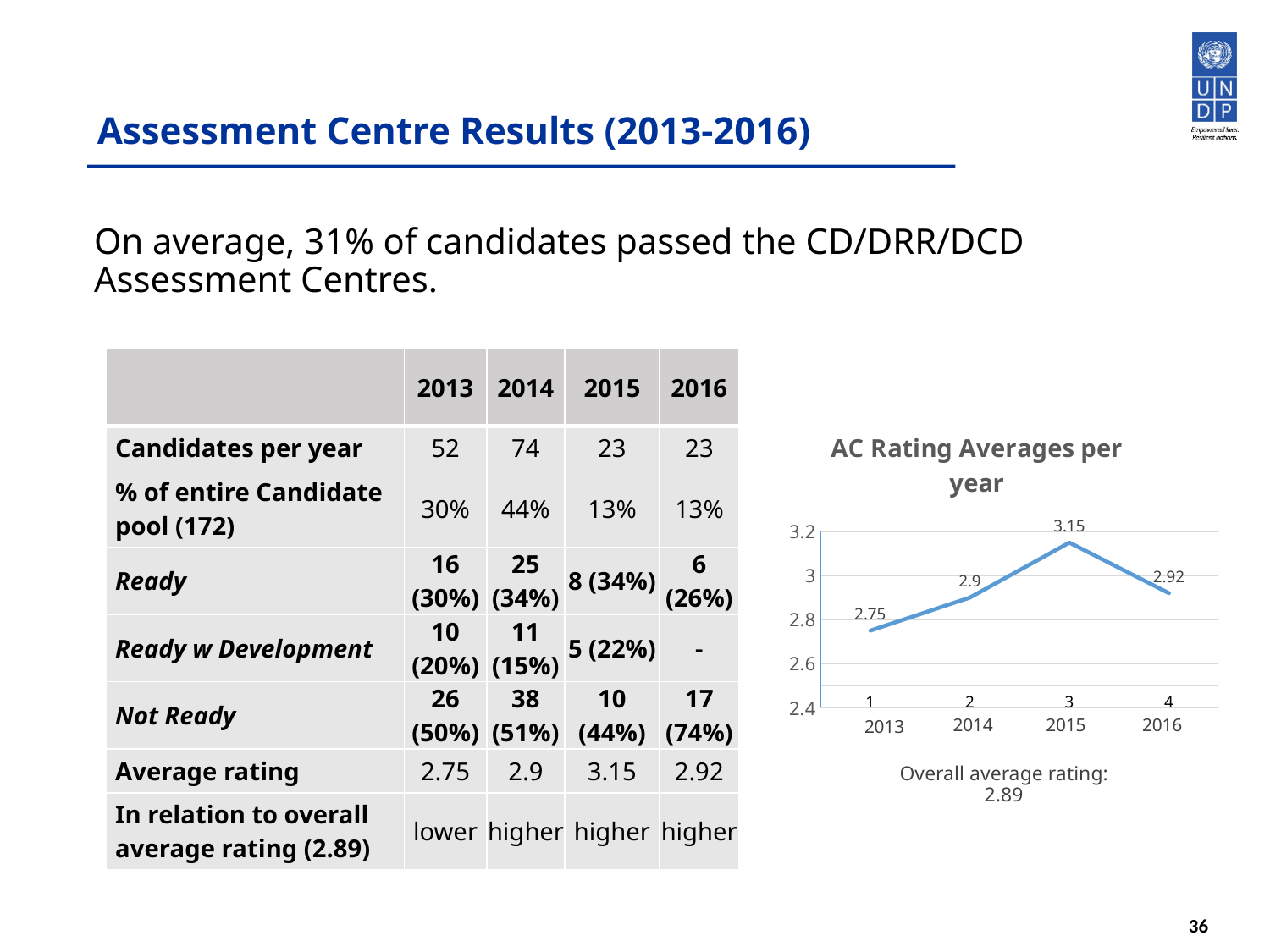
What is the AC rating average for 2016? 2.92 What type of chart is "AC Rating Averages per year"? line chart Which year has the highest AC rating average? 2015 Is the AC rating average for 2014 greater or less than 3? less How many years are plotted in the "AC Rating Averages per year" chart? 4 What is the AC rating average for 2015? 3.15 Which year has the lowest AC rating average? 2013 What is the title of the line chart on the slide? AC Rating Averages per year Which year has a higher AC rating average, 2014 or 2016? 2016 What is the difference between the AC rating averages for 2015 and 2013? 0.4 Does the AC rating average rise or fall from 2013 to 2015? rise What is the AC rating average for 2013? 2.75